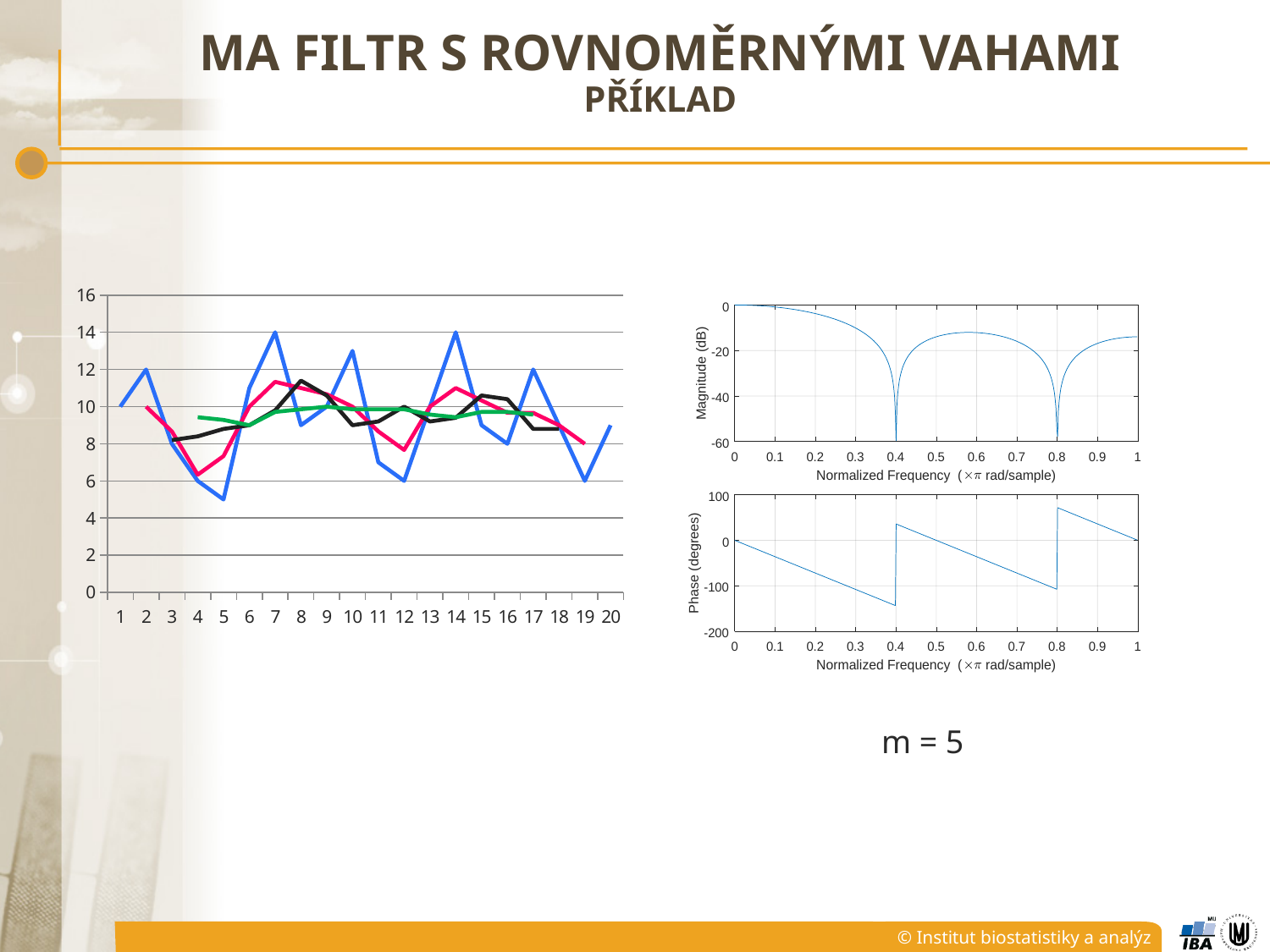
How many points are labelled on the x axis of the left chart? 20 In the Magnitude (dB) chart on the right, what is the magnitude at normalized frequency 0? 0 In the left chart, what is the value of the blue line at x = 2? 12 What kind of chart is the chart on the left side of the slide? line chart What is the highest value shown on the y axis of the left chart? 16 In the left chart, is the value of the green line at x = 10 greater or less than 8? greater What is the y-axis label of the bottom chart on the right side of the slide? Phase (degrees) In the left chart, is the value of the blue line at x = 7 greater or less than 12? greater In the left chart, is the value of the blue line at x = 5 greater or less than 6? less In the left chart, what is the value of the blue line at x = 1? 10 In the left chart, which is larger: the blue line at x = 14 or the blue line at x = 12? blue line at x = 14